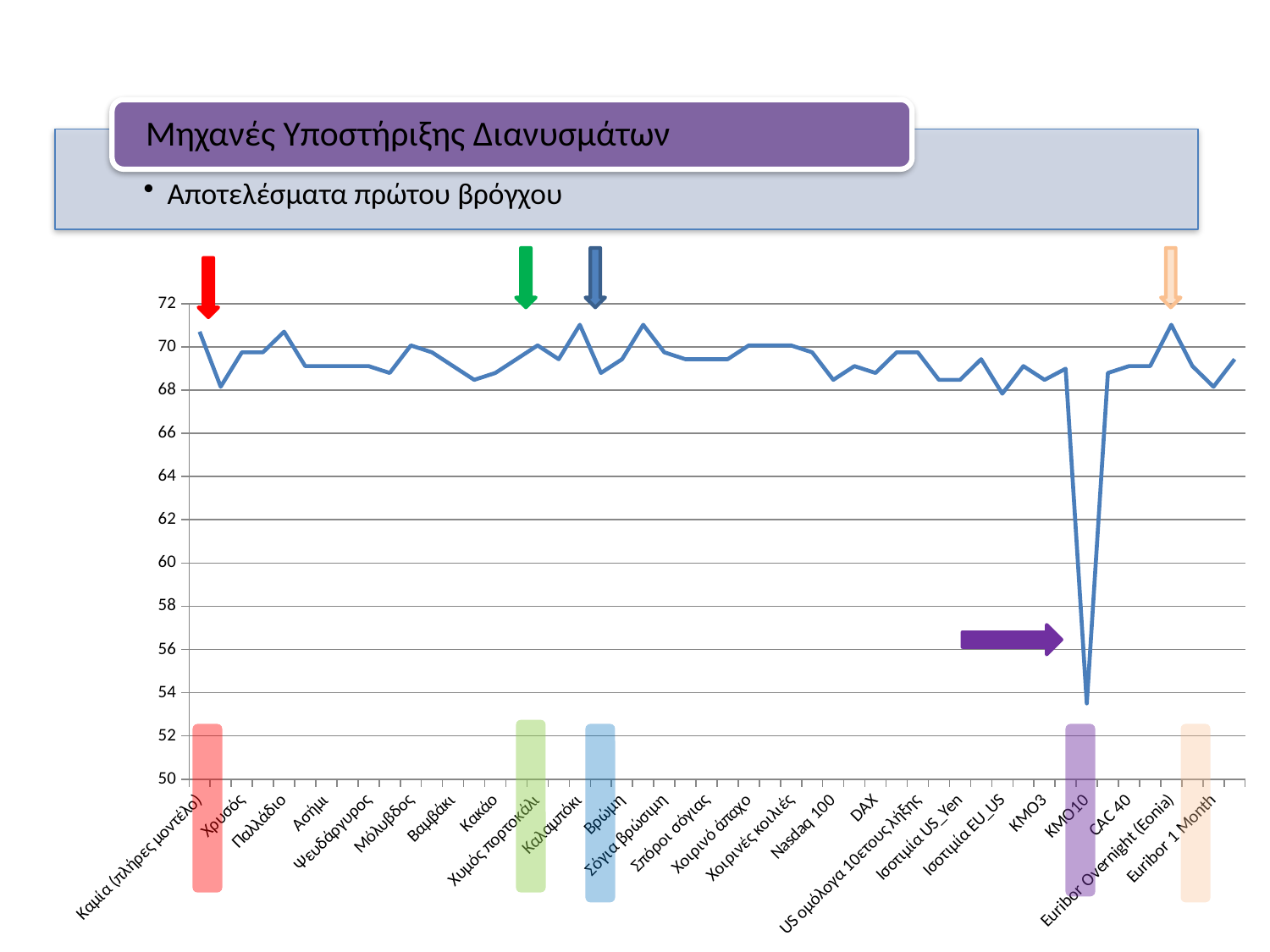
Which has the larger value, KMO10 or CAC 40? CAC 40 Which has the larger value, Χρυσός or Παλλάδιο? Παλλάδιο What is the lowest tick value shown on the vertical axis? 50 Which has the larger value, Καμία (πλήρες μοντέλο) or KMO10? Καμία (πλήρες μοντέλο) What kind of chart is shown on the slide? line chart Is the value for KMO10 greater or less than 56? less What is the highest tick value shown on the vertical axis? 72 Is the value for Euribor Overnight (Eonia) greater or less than 70? greater Is the value for Χρυσός greater or less than 70? less Which category has the lowest value on the chart? KMO10